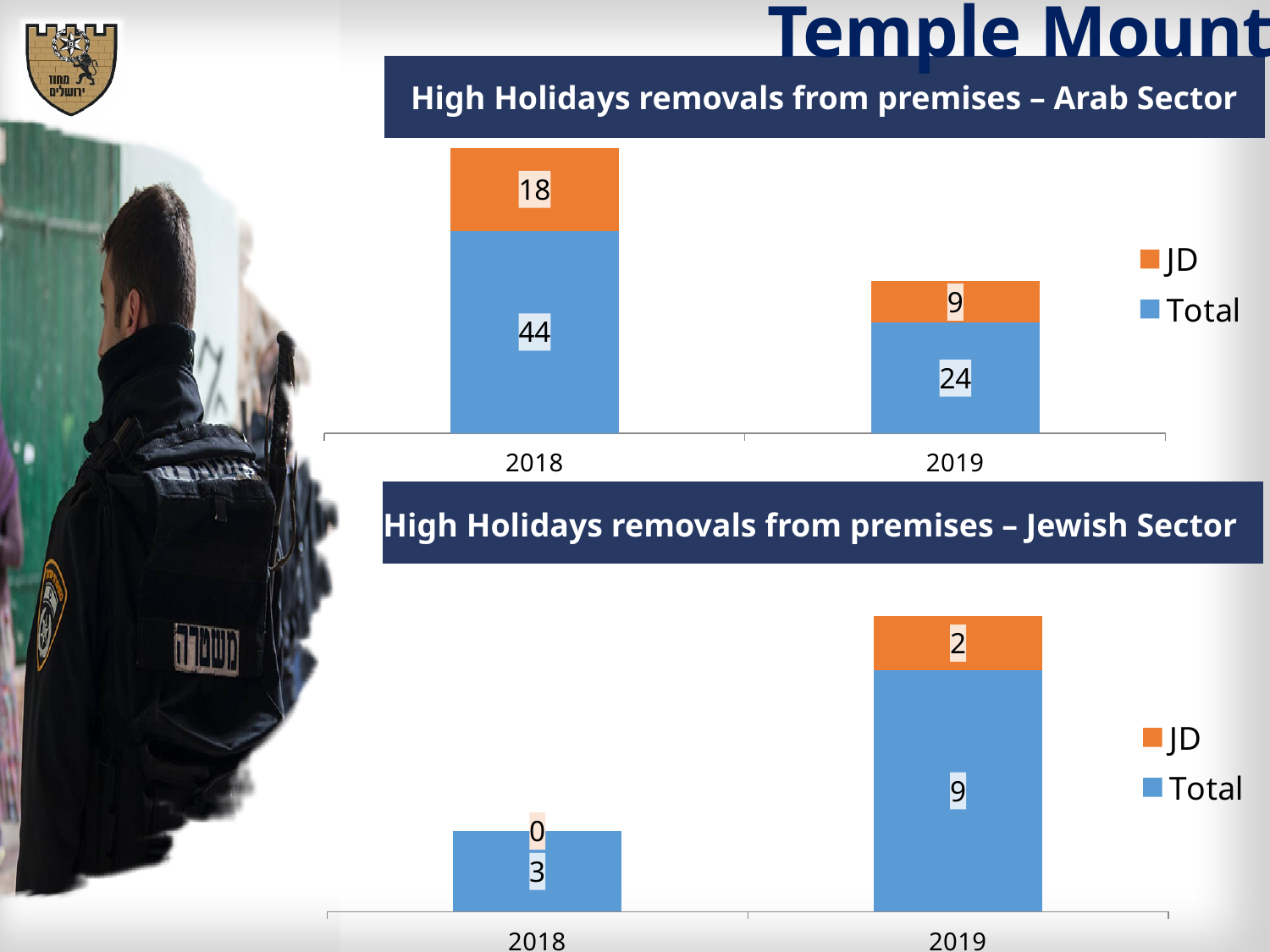
How many series does the legend list in the 'High Holidays removals from premises – Arab Sector' chart? 2 In the 'High Holidays removals from premises – Jewish Sector' chart, what is the Total value for 2019? 9 In the 'High Holidays removals from premises – Jewish Sector' chart, does the Total value rise or fall from 2018 to 2019? rise In the 'High Holidays removals from premises – Arab Sector' chart, what is the Total value for 2018? 44 In the 'High Holidays removals from premises – Arab Sector' chart, which year has the higher JD value? 2018 In the 'High Holidays removals from premises – Arab Sector' chart, what is the combined height of the stacked bar for 2018? 62 In the 'High Holidays removals from premises – Jewish Sector' chart, what is the combined height of the stacked bar for 2019? 11 In the 'High Holidays removals from premises – Jewish Sector' chart, what is the JD value for 2018? 0 In the 'High Holidays removals from premises – Arab Sector' chart, what is the JD value for 2019? 9 In the 'High Holidays removals from premises – Arab Sector' chart, what is the difference between the Total values for 2018 and 2019? 20 How many years are shown on the x axis of the 'High Holidays removals from premises – Jewish Sector' chart? 2 What kind of chart is the 'High Holidays removals from premises – Arab Sector' chart? stacked bar chart